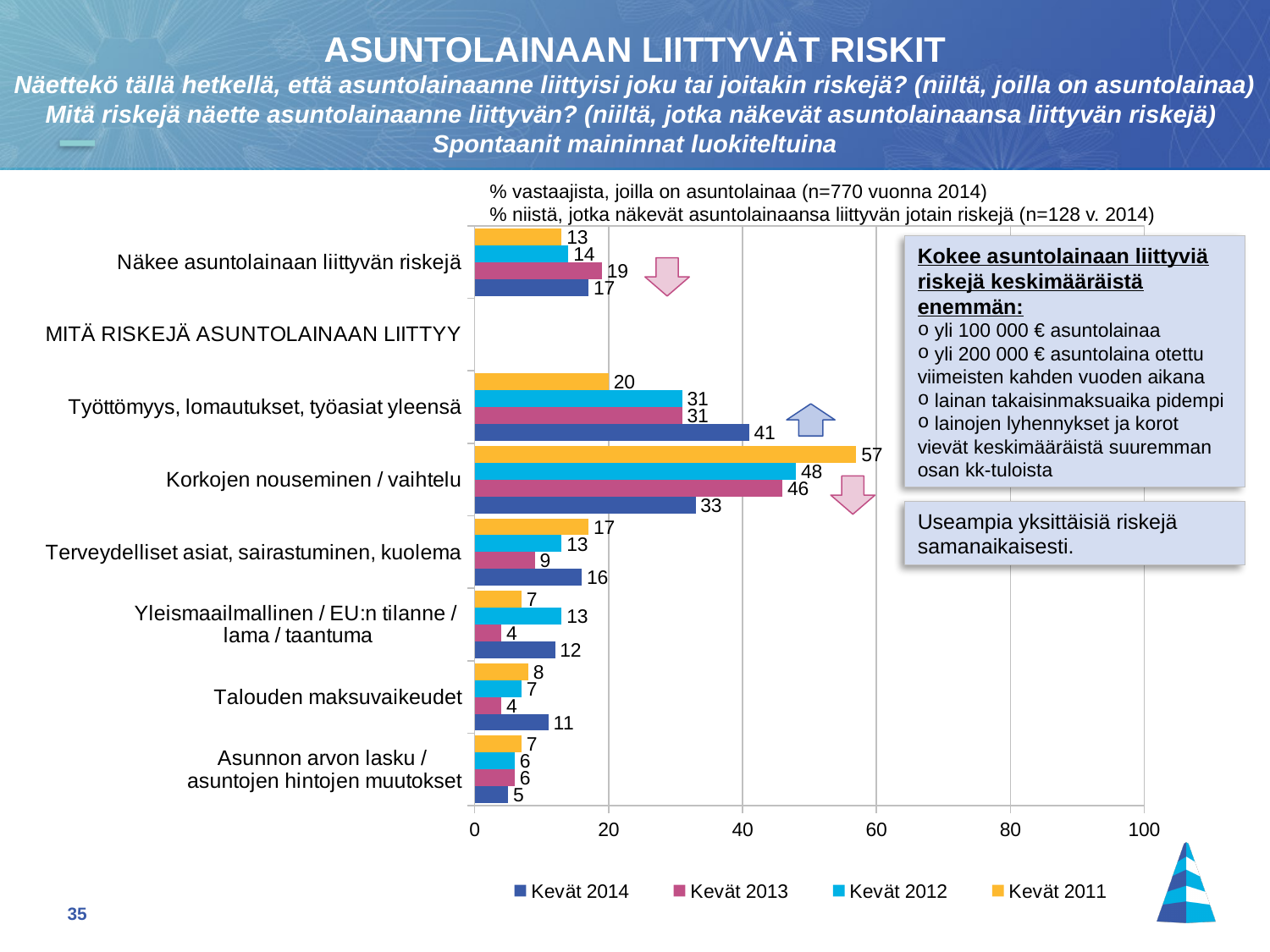
Which series is shown in yellow in the legend? Kevät 2011 Is the Kevät 2012 value for Korkojen nouseminen / vaihtelu greater or less than 40? greater What kind of chart is shown on the slide? bar chart Which risk category has the highest Kevät 2014 value? Työttömyys, lomautukset, työasiat yleensä What is the difference between the Kevät 2011 and Kevät 2014 values for Korkojen nouseminen / vaihtelu? 24 What is the Kevät 2014 value for Työttömyys, lomautukset, työasiat yleensä? 41 What is the Kevät 2011 value for Korkojen nouseminen / vaihtelu? 57 For Talouden maksuvaikeudet, which is larger: the Kevät 2014 value or the Kevät 2013 value? Kevät 2014 What is the Kevät 2012 value for Yleismaailmallinen / EU:n tilanne / lama / taantuma? 13 How many series does the legend list? 4 Which risk category has the lowest Kevät 2014 value? Asunnon arvon lasku / asuntojen hintojen muutokset What is the Kevät 2013 value for Terveydelliset asiat, sairastuminen, kuolema? 9